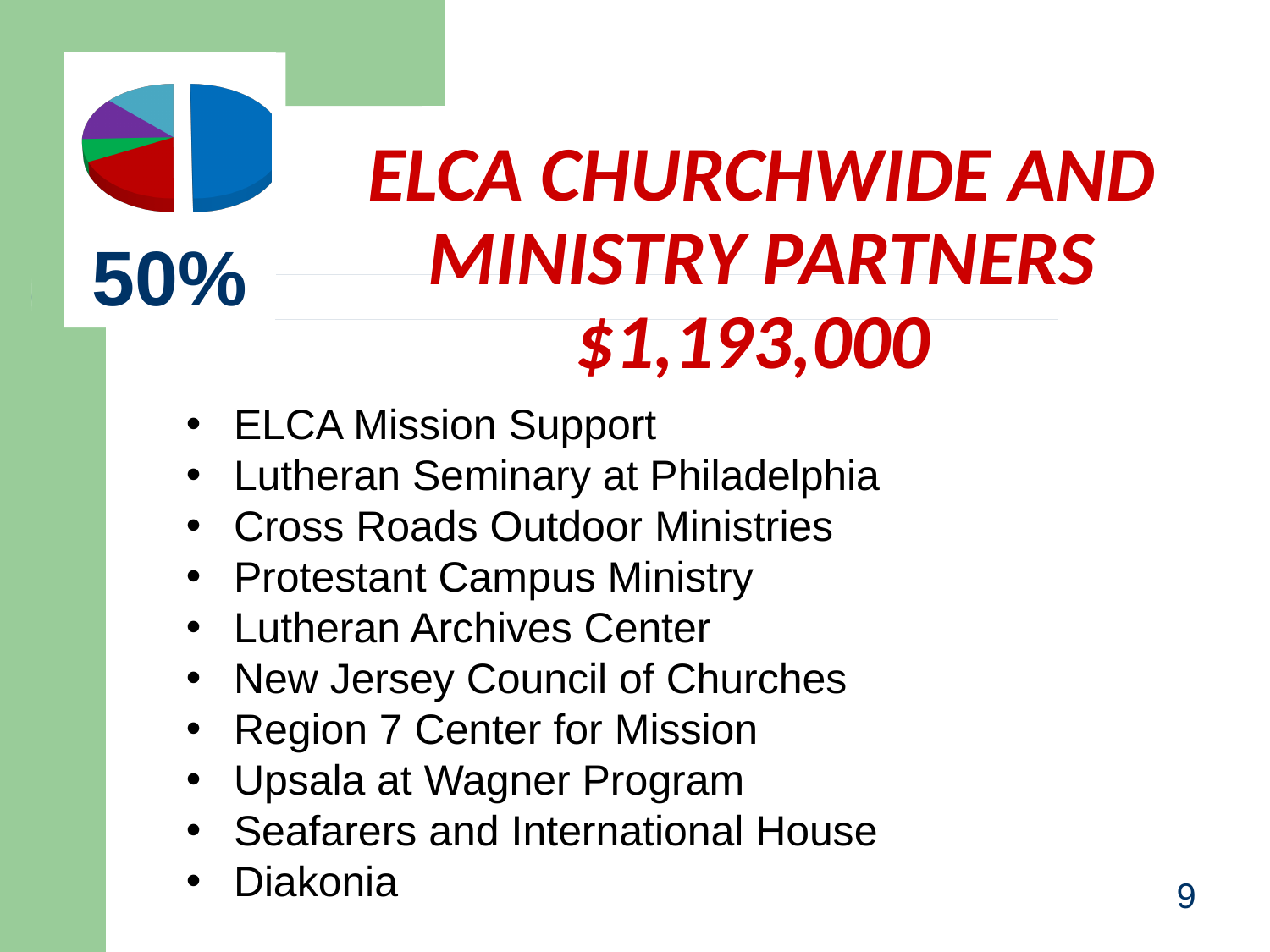
In the pie chart, which slice is larger, the blue one or the red one? blue In the pie chart, which slice is larger, the red one or the green one? red Which colour slice is the largest in the pie chart? blue What kind of chart is shown in the top-left corner of the slide? pie chart What percentage is printed beside the pie chart? 50% How many slices does the pie chart have? 5 Which slice of the pie chart is pulled out (exploded) from the rest? the blue slice